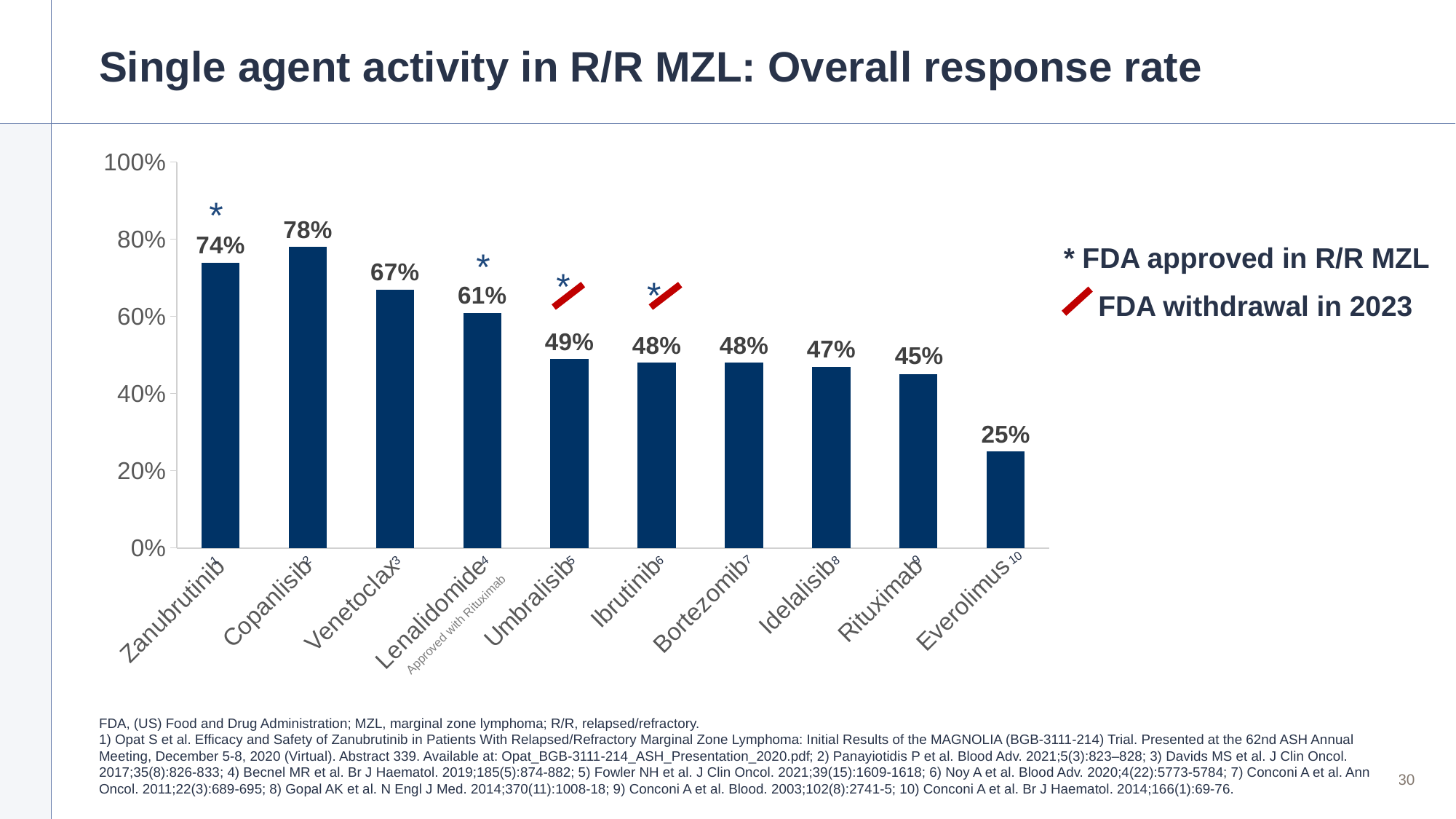
What is the overall response rate shown for Lenalidomide? 61% What is the overall response rate shown for Copanlisib? 78% Do the overall response rates generally rise or fall from left to right across the chart? Fall What is the overall response rate shown for Everolimus? 25% What type of chart is shown on the slide? Bar chart According to the legend, what does the asterisk symbol above a bar indicate? FDA approved in R/R MZL Which agent has the lowest overall response rate on the chart? Everolimus What is the overall response rate shown for Zanubrutinib? 74% Which has a higher overall response rate, Zanubrutinib or Rituximab? Zanubrutinib What is the difference between the overall response rates of Copanlisib and Venetoclax? 11% Which agent has the highest overall response rate on the chart? Copanlisib How many agents are shown on the chart? 10